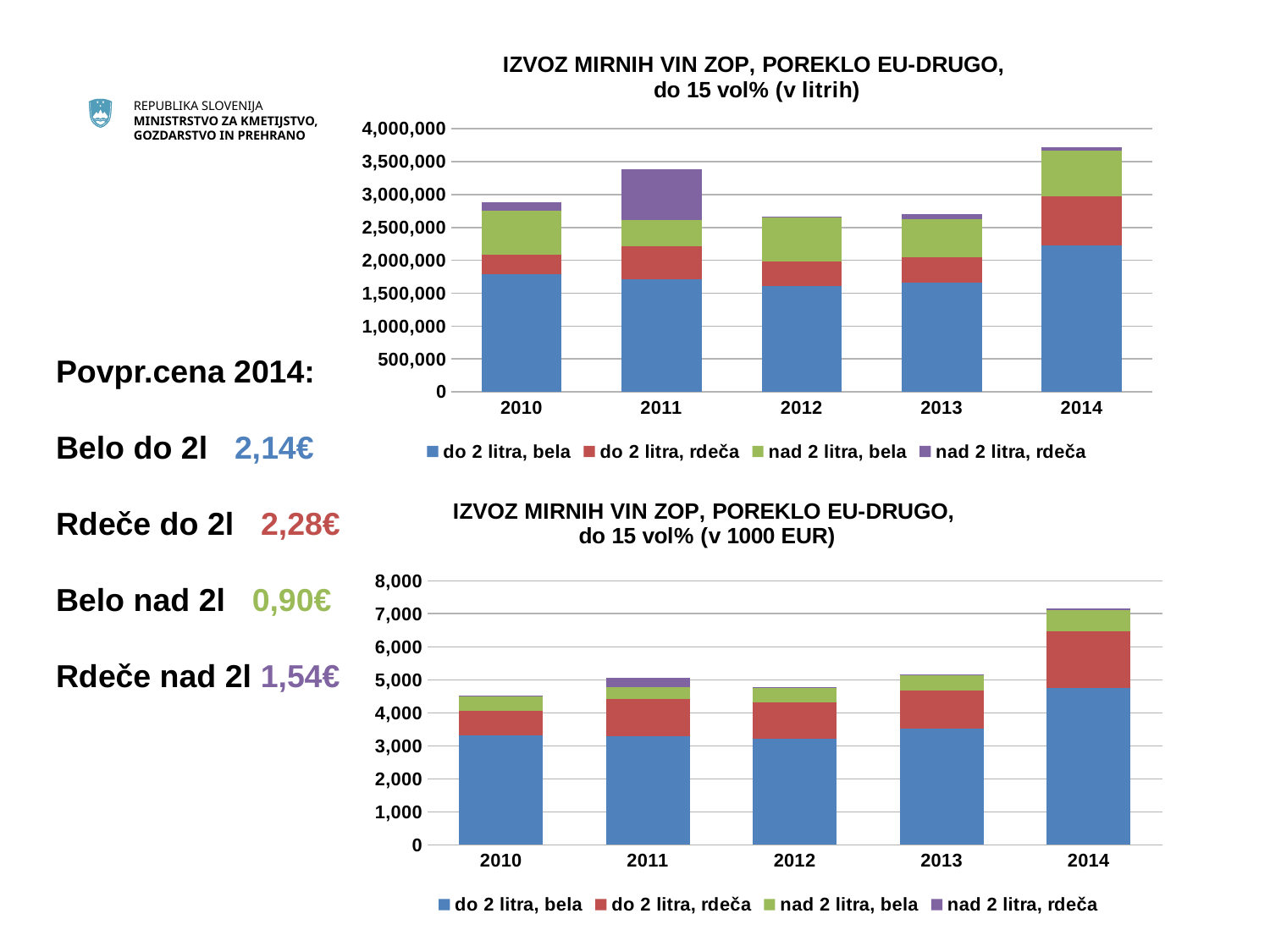
In the bottom chart (v 1000 EUR), is the total for 2014 greater or less than 7,000? greater What kind of chart is the bottom chart (v 1000 EUR)? stacked bar chart In the top chart (v litrih), is the 'do 2 litra, bela' value for 2014 greater or less than 2,000,000? greater How many series does the legend of the top chart (v litrih) list? 4 In the top chart (v litrih), is the total for 2011 greater or less than 3,000,000? greater In the top chart (v litrih), which year has the larger total, 2011 or 2012? 2011 In the bottom chart (v 1000 EUR), which year has the larger total, 2013 or 2014? 2014 In the bottom chart (v 1000 EUR), which year has the tallest stacked bar? 2014 How many years are shown on the x axis of the bottom chart (v 1000 EUR)? 5 In the top chart (v litrih), which year has the tallest stacked bar? 2014